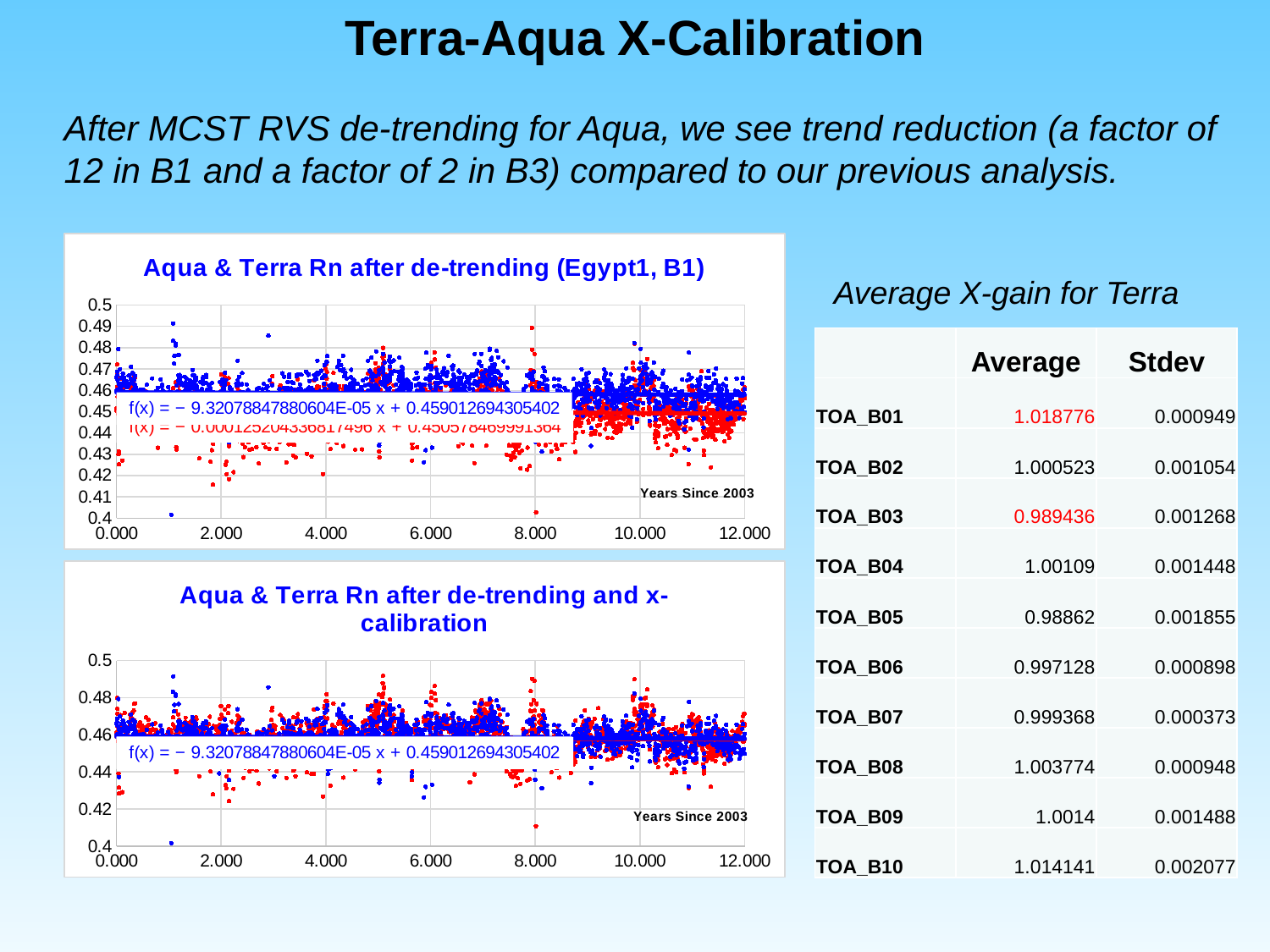
In the top chart, is the intercept of the blue fitted line greater or less than 0.44? greater In the top chart, is the intercept of the blue fitted line greater or less than 0.48? less In the bottom chart, what is the slope of the fitted line f(x) shown on the chart? − 9.32078847880604E-05 What is the title of the bottom chart on the slide? Aqua & Terra Rn after de-trending and x-calibration In the bottom chart, what is the lowest value shown on the y axis? 0.4 What kind of chart is the top chart, 'Aqua & Terra Rn after de-trending (Egypt1, B1)'? scatter chart How many fitted line equations are printed on the top chart? 2 In the top chart, what is the intercept of the blue fitted line f(x) shown on the chart? 0.459012694305402 In the bottom chart, what is the highest value shown on the y axis? 0.5 According to the fitted line equation in the bottom chart, do the values rise or fall as years since 2003 increase? fall In the top chart, what is the label on the x axis? Years Since 2003 In the top chart, what is the highest value shown on the x axis? 12.000